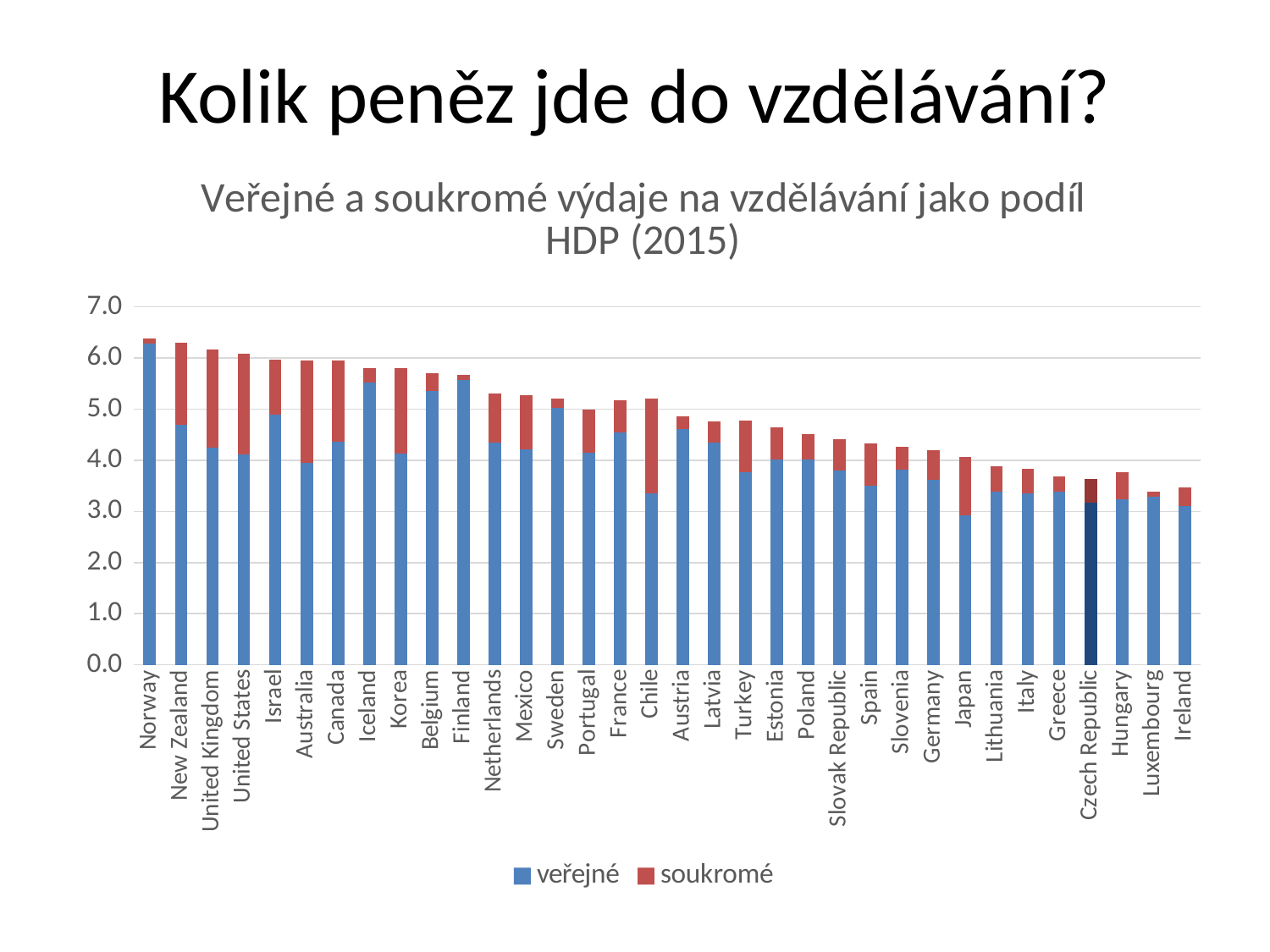
Do the total bar heights generally rise or fall from left to right along the x axis? fall Is the total value for Czech Republic greater or less than 4.0? less Is the veřejné (public) value for Finland greater or less than 5.0? greater Which has the larger soukromé (private) value, Chile or Finland? Chile Is the soukromé (private) value for Chile greater or less than 1.0? greater How many series does the legend list? 2 Which country has the highest total expenditure on education as a share of GDP? Norway How many countries are shown on the x axis? 34 Which country's bar is highlighted in a darker blue colour? Czech Republic What kind of chart is shown on the slide? stacked bar chart Which has the larger veřejné (public) value, Norway or New Zealand? Norway